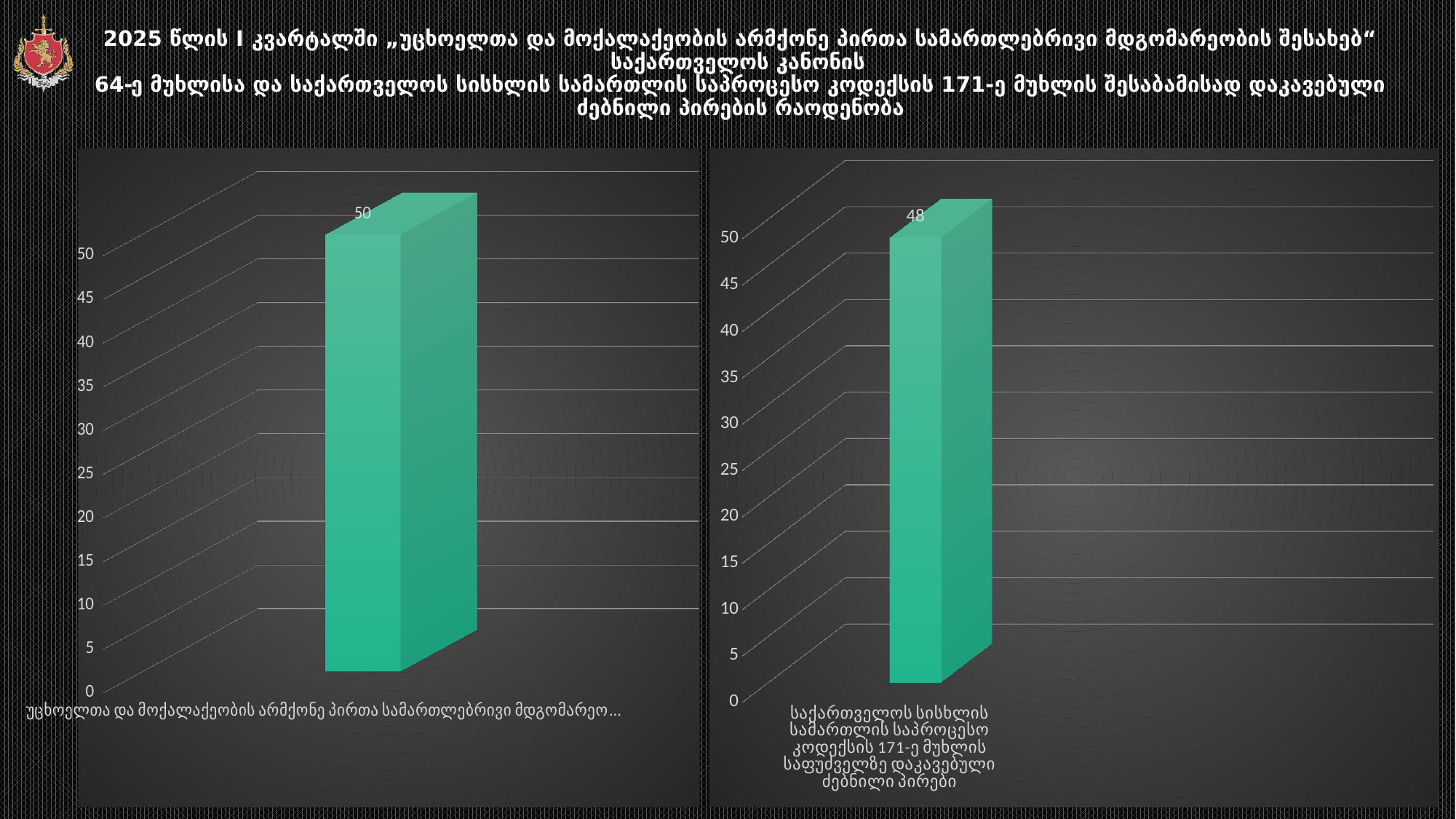
What kind of chart is the right chart? bar chart How many bars are plotted in the right chart? 1 In the right chart, what value is shown on the bar for persons detained under Article 171 of the Criminal Procedure Code of Georgia? 48 What is the highest tick value shown on the vertical axis of the right chart? 50 In the right chart, is the value of the bar greater or less than 45? greater How many bars are plotted in the left chart? 1 What kind of chart is the left chart? bar chart Which chart shows the larger value, the left chart or the right chart? the left chart What is the difference between the value in the left chart (50) and the value in the right chart (48)? 2 In the left chart, what value is shown on the bar? 50 In the left chart, is the value of the bar greater or less than 40? greater What colour are the bars in both charts? green